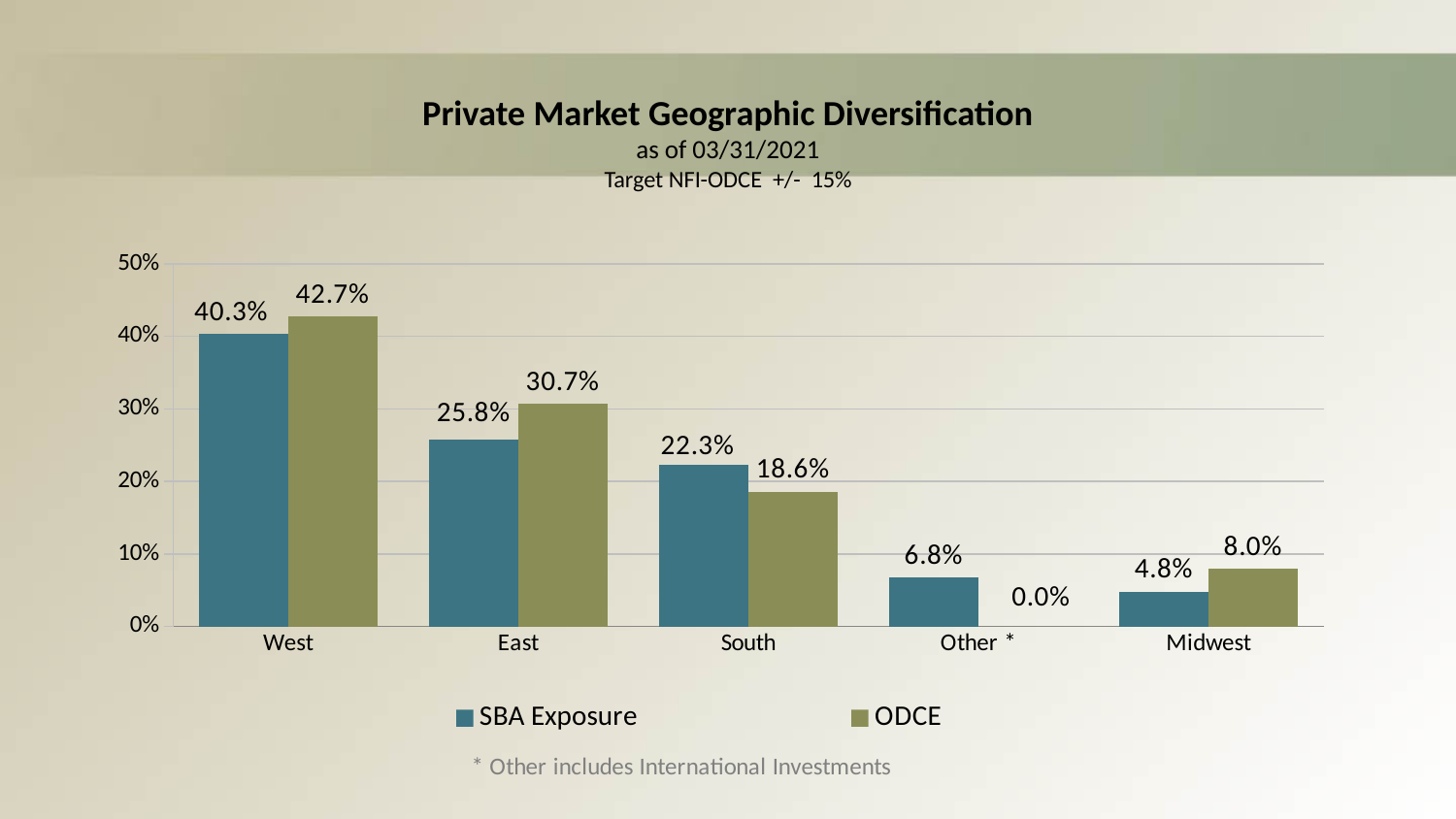
How many series does the legend list? 2 What is the difference between the ODCE and SBA Exposure values for West? 2.4% What is the SBA Exposure value for West? 40.3% How many regions are shown on the x axis? 5 What is the title of the chart? Private Market Geographic Diversification What is the difference between the SBA Exposure and ODCE values for South? 3.7% What is the ODCE value for East? 30.7% Which region has the highest SBA Exposure? West What is the ODCE value for Other? 0.0% Which is larger for Midwest, SBA Exposure or ODCE? ODCE Which region has the lowest ODCE value? Other What kind of chart is shown on the slide? Bar chart